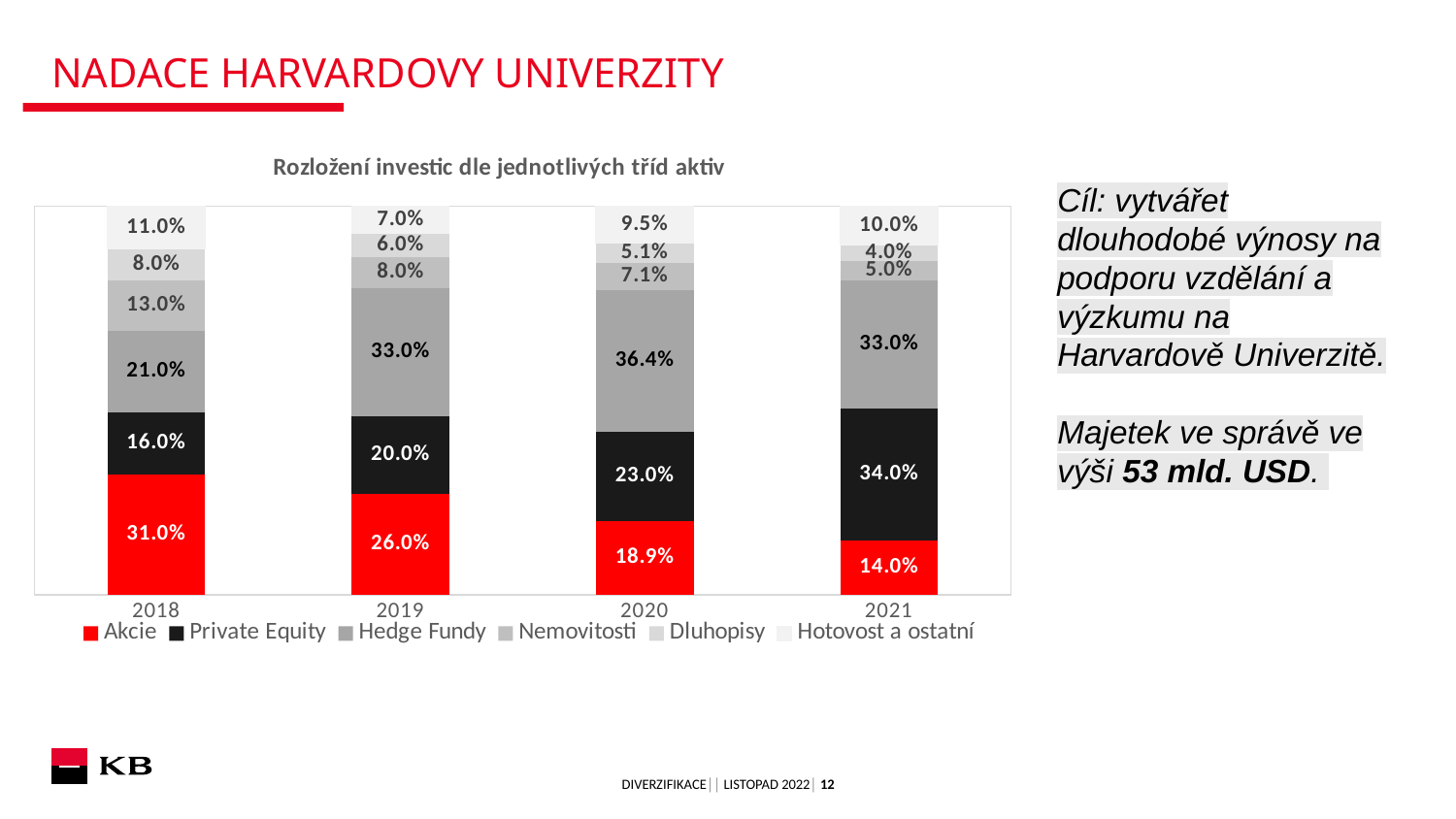
Which is larger in 2019: Hedge Fundy or Akcie? Hedge Fundy Does the Akcie share rise or fall from 2018 to 2021? Fall What is the difference between the Akcie value in 2018 and in 2021? 17.0% What type of chart is shown on the slide? Stacked bar chart How many series does the legend list? 6 In which year is the Private Equity share the highest? 2021 What is the title of the chart? Rozložení investic dle jednotlivých tříd aktiv What is the value for Hedge Fundy in 2020? 36.4% What is the value for Akcie in 2018? 31.0% What is the value for Private Equity in 2021? 34.0% In which year is the Akcie share the lowest? 2021 How many years are shown on the x axis? 4